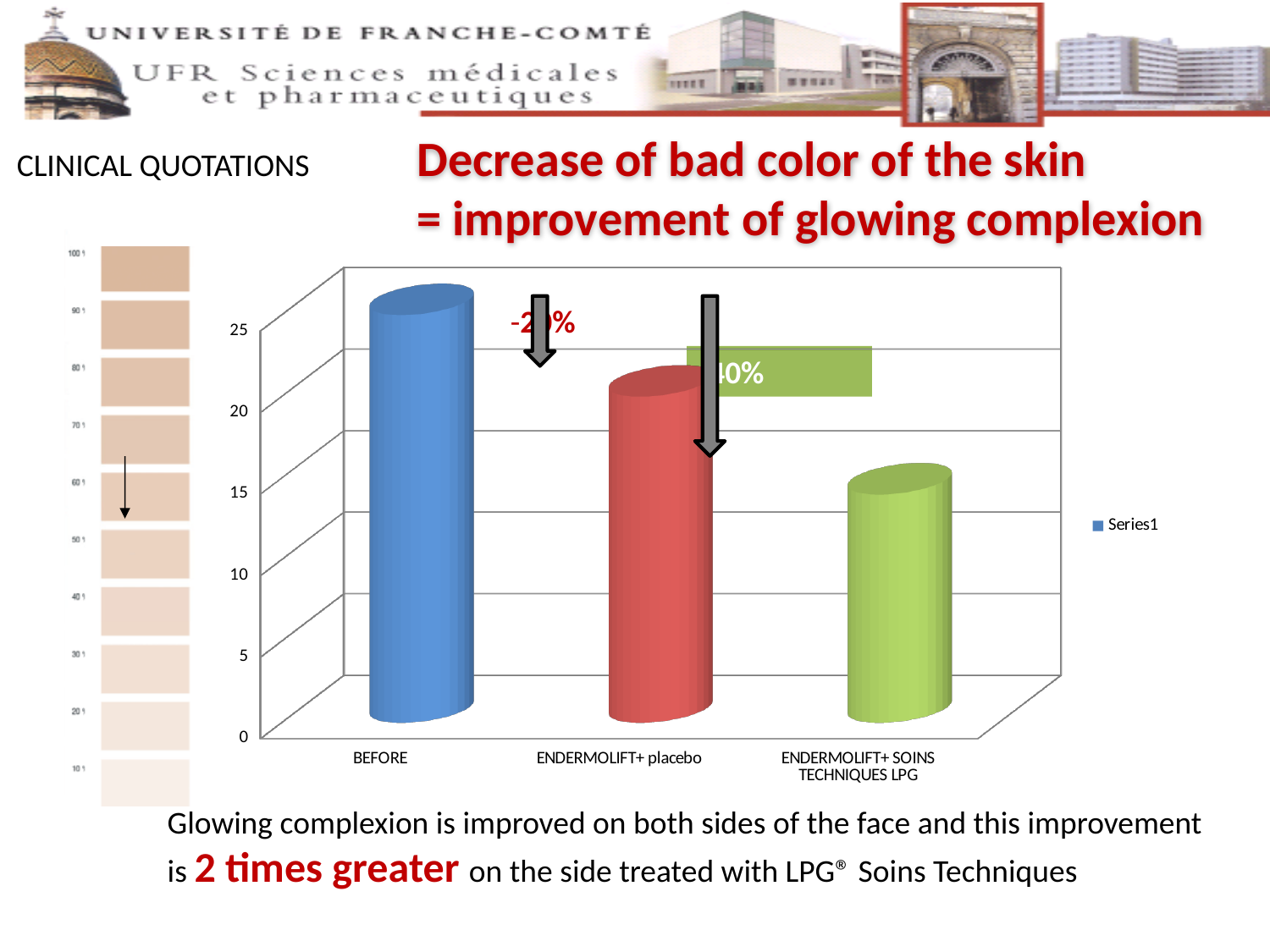
How many series does the chart legend list? 1 Do the bar values rise or fall from left to right along the x axis? fall Is the value for BEFORE greater or less than 20? greater What is the name of the series shown in the chart legend? Series1 Which category has the lowest bar in the chart? ENDERMOLIFT+ SOINS TECHNIQUES LPG Which category has the highest bar in the chart? BEFORE Which is larger, the value for ENDERMOLIFT+ placebo or the value for ENDERMOLIFT+ SOINS TECHNIQUES LPG? ENDERMOLIFT+ placebo Which is larger, the value for BEFORE or the value for ENDERMOLIFT+ SOINS TECHNIQUES LPG? BEFORE How many categories are plotted on the x axis of the chart? 3 Is the value for ENDERMOLIFT+ placebo greater or less than 15? greater Is the value for ENDERMOLIFT+ SOINS TECHNIQUES LPG greater or less than 20? less What kind of chart is shown on the slide? bar chart